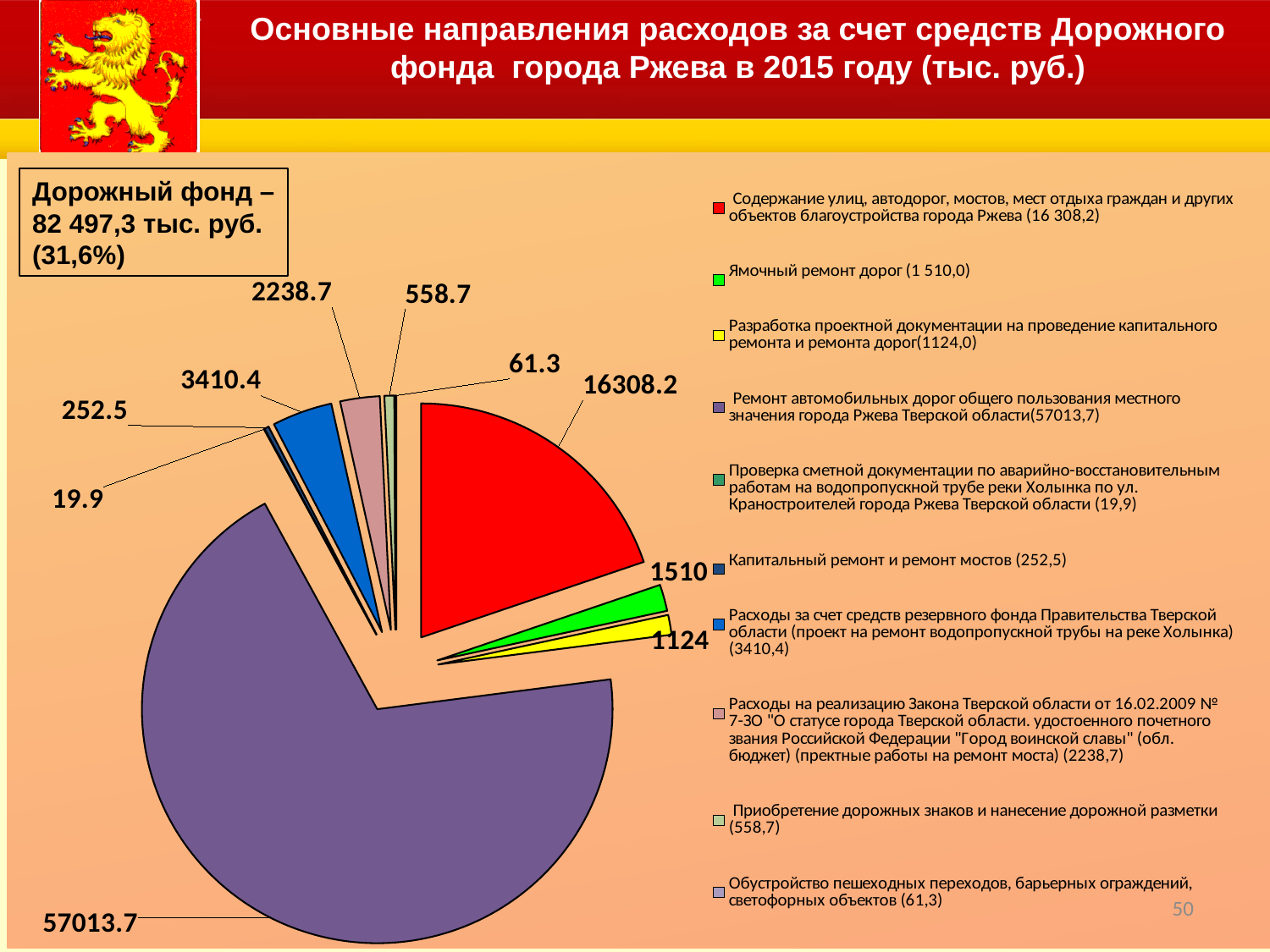
What is the value of the smallest slice of the pie chart? 19.9 How many slices does the pie chart have? 10 What is the value of the largest slice of the pie chart? 57013.7 What is the value for Приобретение дорожных знаков и нанесение дорожной разметки? 558.7 What is the value labelled on the red slice (Содержание улиц, автодорог, мостов...)? 16308.2 Which category has the largest slice in the pie chart? Ремонт автомобильных дорог общего пользования местного значения города Ржева Тверской области How many entries does the legend list? 10 What is the difference between the largest slice (57013.7) and the red slice (16308.2)? 40705.5 Which is larger: the slice for Ямочный ремонт дорог or the slice for Разработка проектной документации? Ямочный ремонт дорог (1510) What is the value for Ямочный ремонт дорог in the pie chart? 1510 What total amount of the Дорожный фонд is stated in the text box on the slide? 82 497,3 тыс. руб. What kind of chart is shown on the slide? pie chart